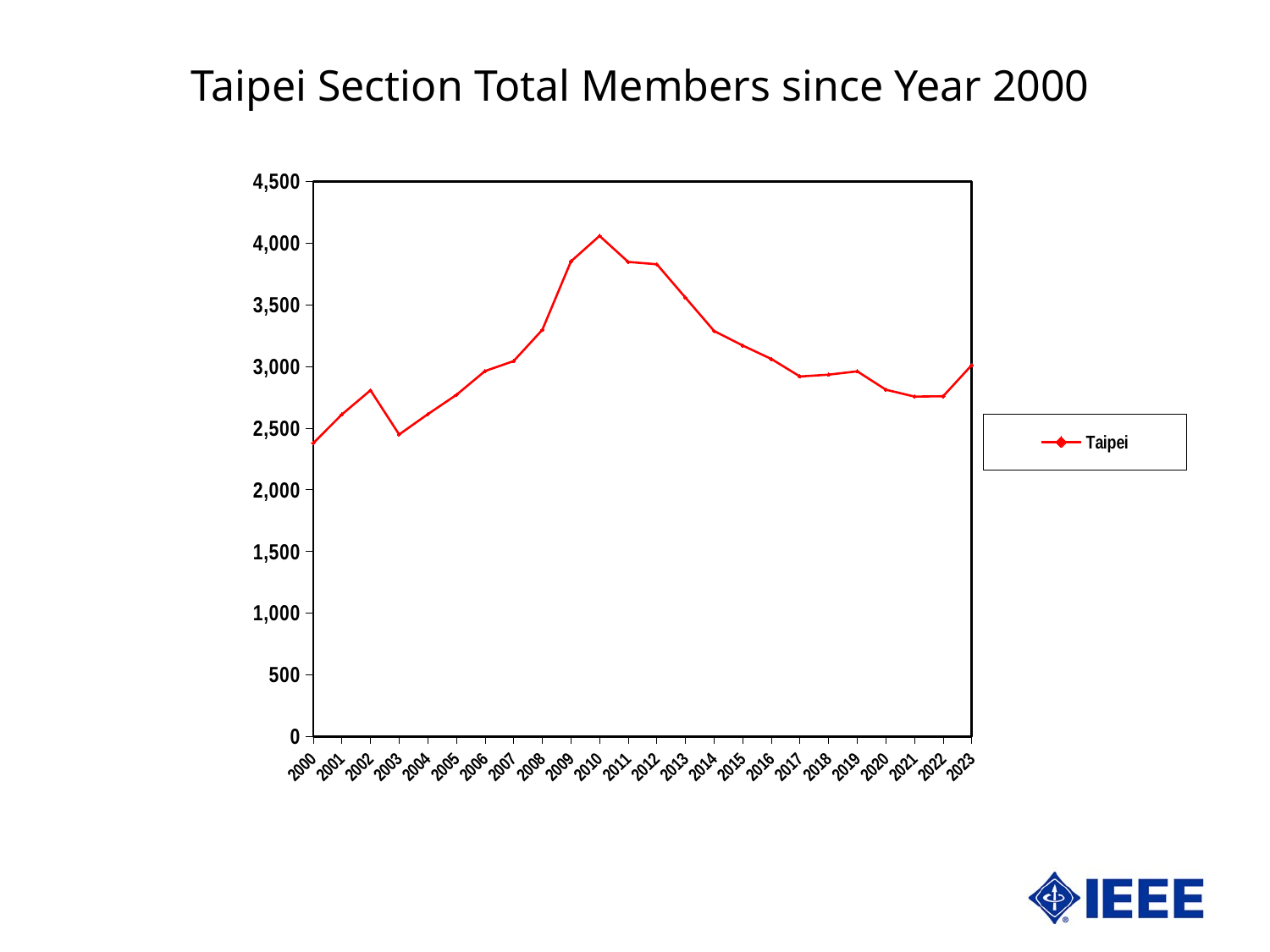
Is the value for 2021 greater or less than 3,000? less In which year is the number of Taipei members highest? 2010 What is the title of the chart? Taipei Section Total Members since Year 2000 Is the value for 2000 greater or less than 2,500? less What kind of chart is shown on the slide? Line chart How many years are plotted along the x axis? 24 Do the values rise or fall from 2010 to 2017? fall Which year has more members, 2002 or 2003? 2002 Is the value for 2008 greater or less than 3,500? less What is the name of the series shown in the legend? Taipei How many series does the legend list? 1